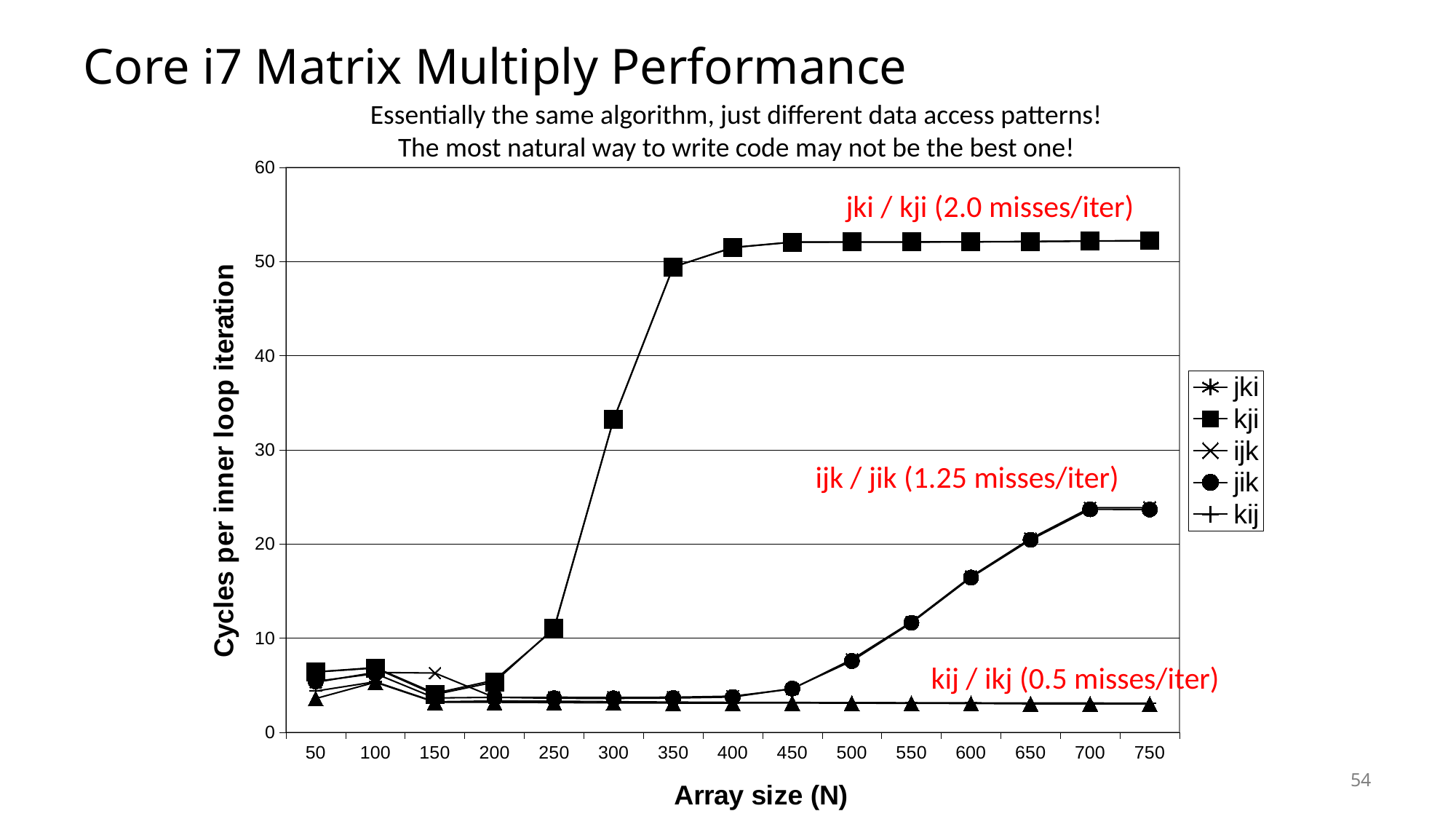
Is the value for kji at array size 200 greater or less than 10? less Is the value for jik at array size 500 greater or less than 10? less Does the kji series rise or fall between array size 200 and array size 350? rise Is the value for jik at array size 750 greater or less than 20? greater How many series does the legend list? 5 What kind of chart is shown on the slide? line chart What is the title of the x axis? Array size (N) How many array size values are marked along the x axis? 15 At array size 750, which is larger, the value for kji or the value for jik? kji